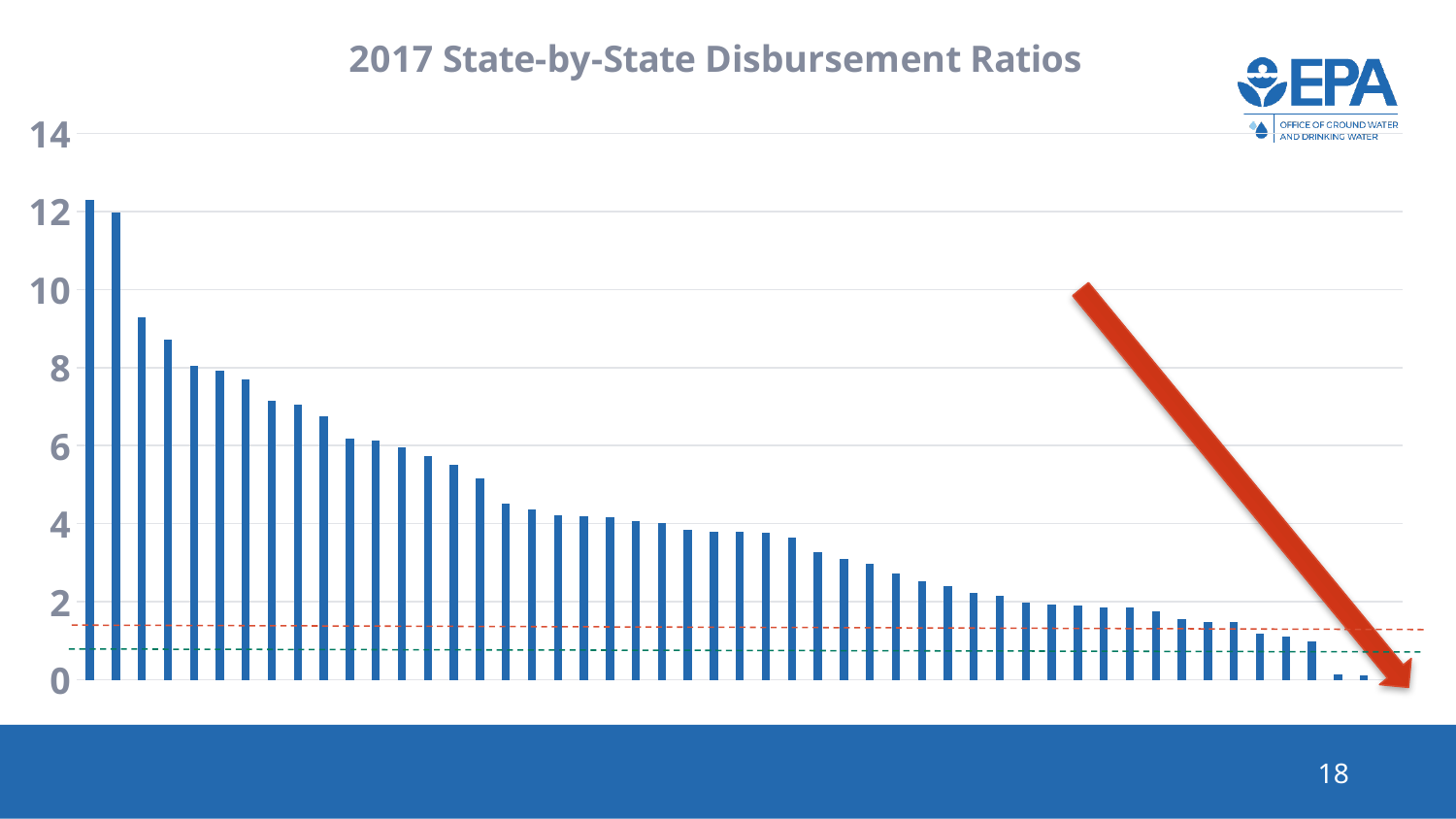
What is the title of the chart? 2017 State-by-State Disbursement Ratios Is the value of the shortest bar greater or less than 2? less Is the value of the third bar from the left greater or less than 10? less What kind of chart is shown on the slide? bar chart Do the bar values rise or fall from left to right along the x axis? fall Is the tallest bar on the left or the right side of the chart? left Is the value of the second bar from the left greater or less than 10? greater What is the highest value shown on the y axis? 14